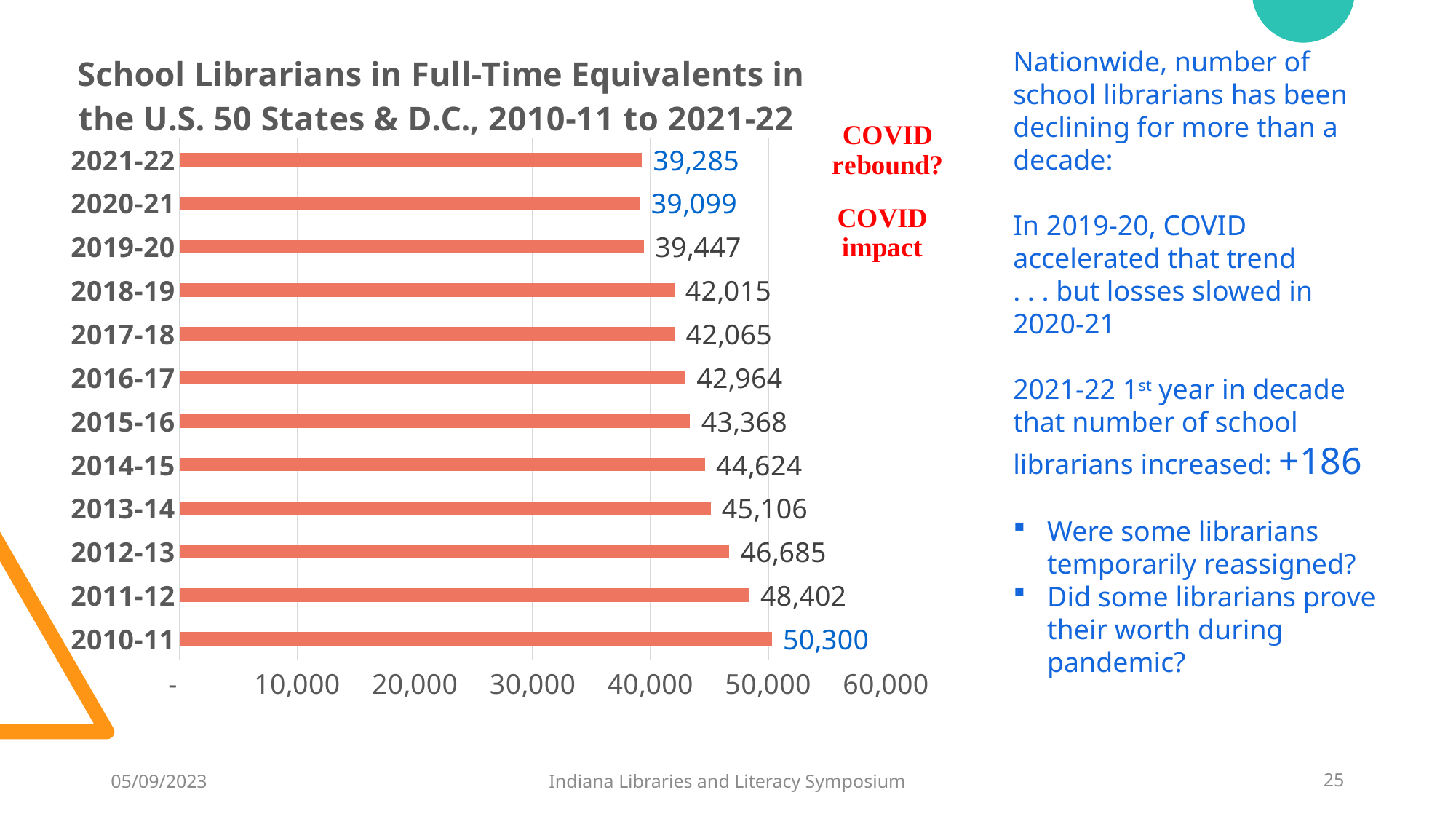
What is the value for 2010-11? 50,300 Which year has the lowest value? 2020-21 What is the difference between the values for 2021-22 and 2020-21? 186 What is the title of the chart? School Librarians in Full-Time Equivalents in the U.S. 50 States & D.C., 2010-11 to 2021-22 Which is larger, the value for 2012-13 or the value for 2016-17? 2012-13 What is the value for 2015-16? 43,368 What is the value for 2021-22? 39,285 What is the difference between the values for 2010-11 and 2021-22? 11,015 What kind of chart is this? bar chart How many years are shown in the chart? 12 Which year has the highest value? 2010-11 Is the value for 2013-14 greater or less than 40,000? greater